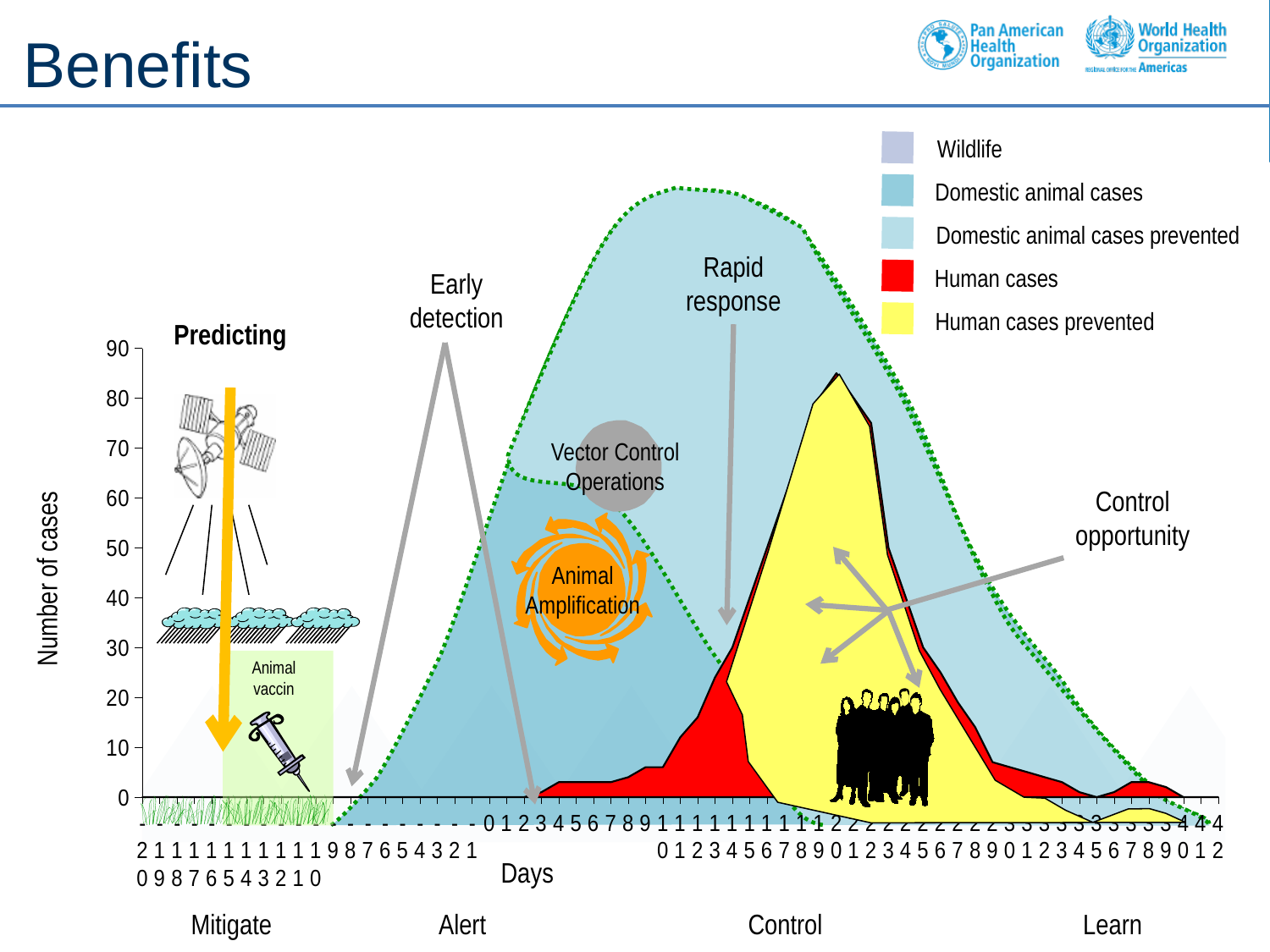
How many entries does the chart's legend list? 5 Which legend entry is shown in yellow? Human cases prevented Is the peak of the yellow 'Human cases prevented' area greater or less than 50? greater What kind of chart is shown on the slide? area chart What is the title of the horizontal axis of the chart? Days Is the peak of the dotted green outline of the 'Domestic animal cases prevented' area greater or less than 80? greater What is the highest value labelled on the vertical axis of the chart? 90 How many phases are labelled along the bottom of the chart (Mitigate, Alert, Control, Learn)? 4 Is the peak of the red 'Human cases' area greater or less than 50? less Which area reaches a higher peak on the chart: 'Human cases prevented' (yellow) or 'Human cases' (red)? Human cases prevented